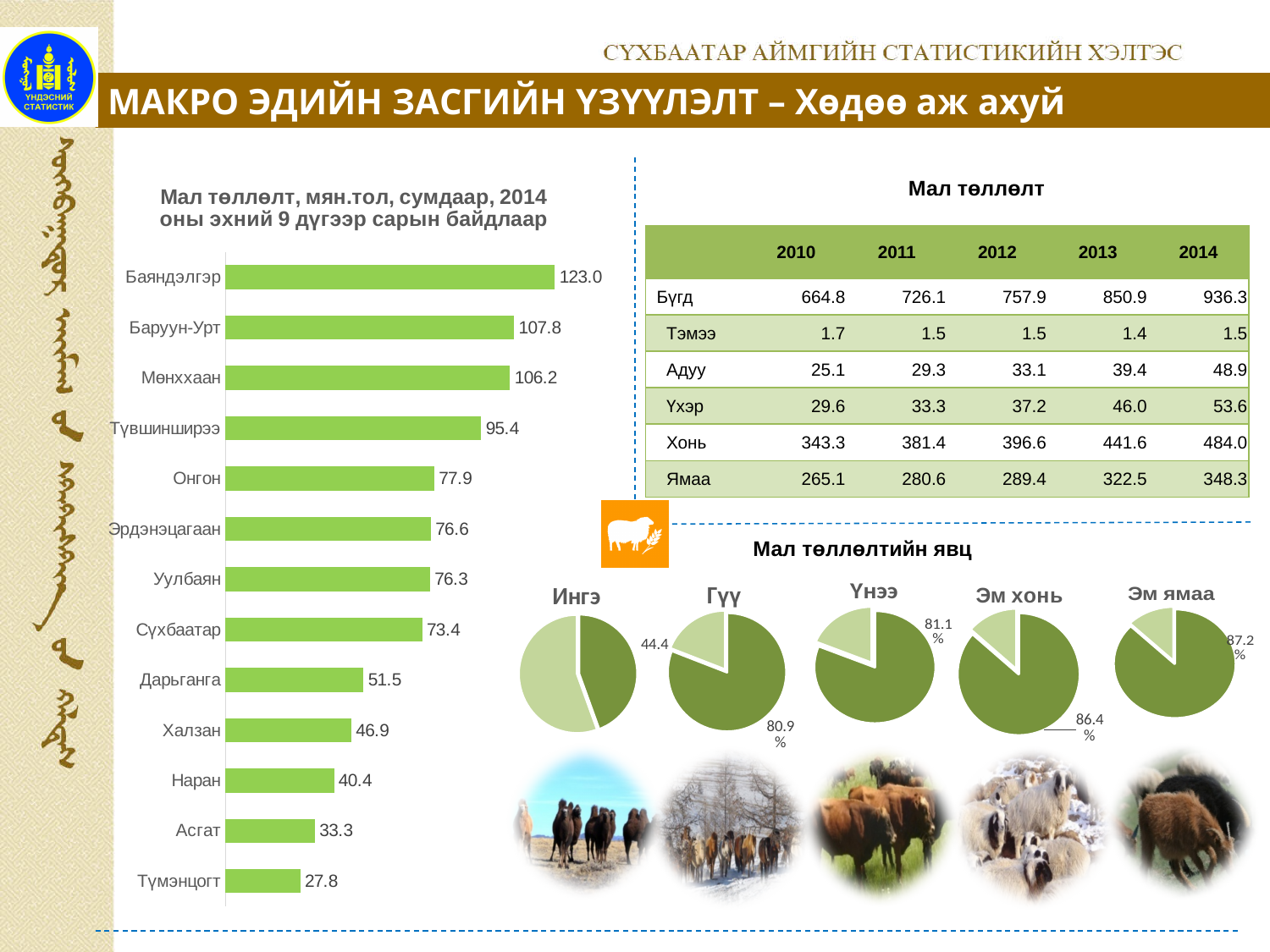
In the pie chart titled 'Гүү', what share is labelled on the larger slice? 80.9% In the pie chart titled 'Эм ямаа', what share is labelled on the larger slice? 87.2% In the bar chart on the left, what is the value for Онгон? 77.9 How many pie charts are shown under the heading 'Мал төллөлтийн явц'? 5 In the bar chart on the left, which category has the highest value? Баяндэлгэр In the bar chart on the left, what is the difference between the values for Баруун-Урт and Мөнххаан? 1.6 In the bar chart on the left, what is the value for Дарьганга? 51.5 In the bar chart 'Мал төллөлт, мян.тол, сумдаар, 2014 оны эхний 9 дүгээр сарын байдлаар', what is the value for Баяндэлгэр? 123.0 In the bar chart on the left, which category has the lowest value? Түмэнцогт In the bar chart on the left, which is larger, the value for Халзан or the value for Наран? Халзан What kind of chart is the chart on the left of the slide? Bar chart How many categories are shown in the bar chart on the left? 13